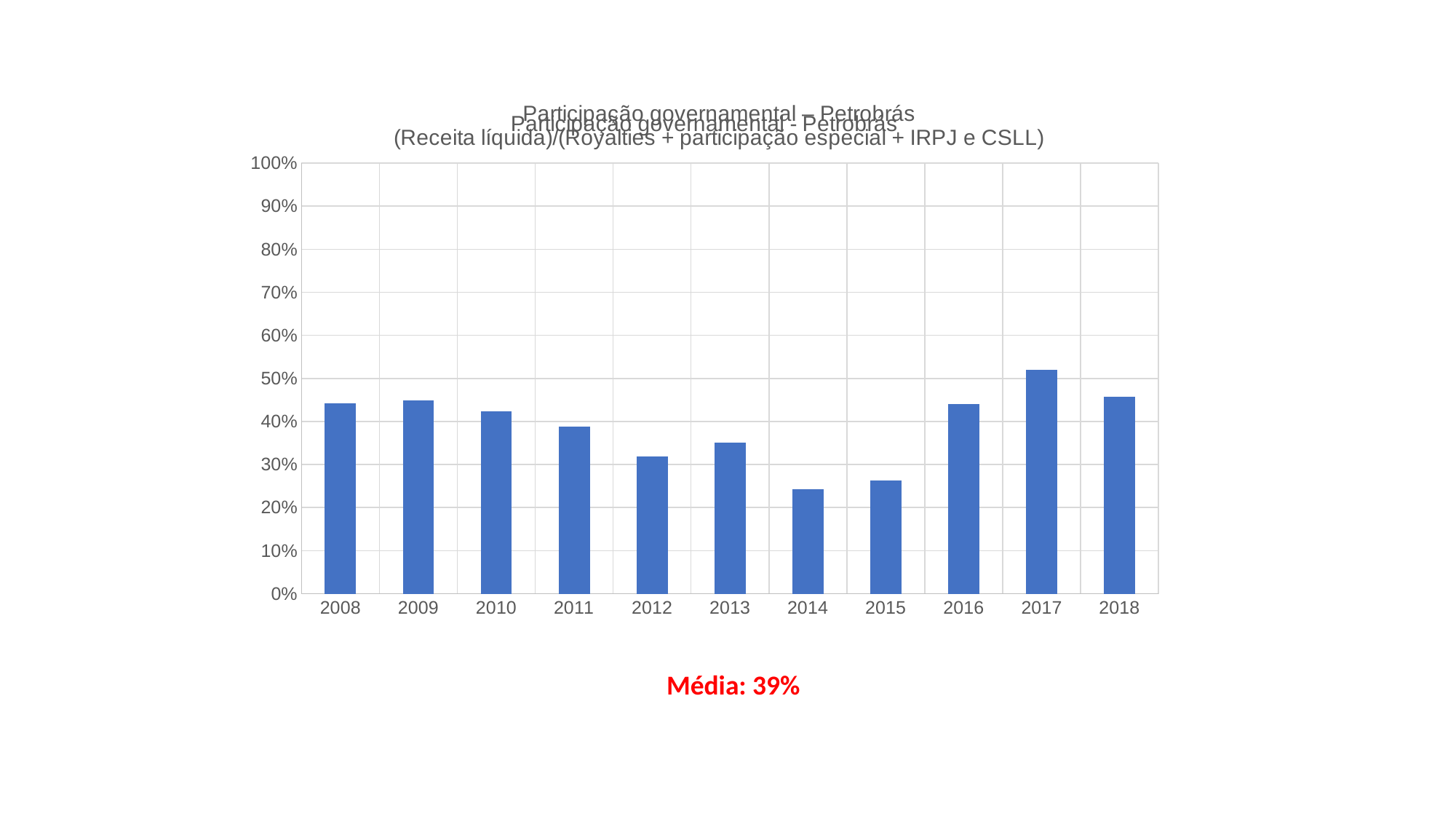
Is the value for 2008 greater or less than 40%? greater Which year has the highest value in the chart? 2017 Is the value for 2014 greater or less than 30%? less Is the value for 2017 greater or less than 50%? greater What kind of chart is shown on the slide? bar chart Do the values rise or fall from 2014 to 2017? rise Which is larger, the value for 2017 or the value for 2018? 2017 What average (Média) is stated below the chart? 39% Which is larger, the value for 2008 or the value for 2014? 2008 How many years are plotted on the x axis of the chart? 11